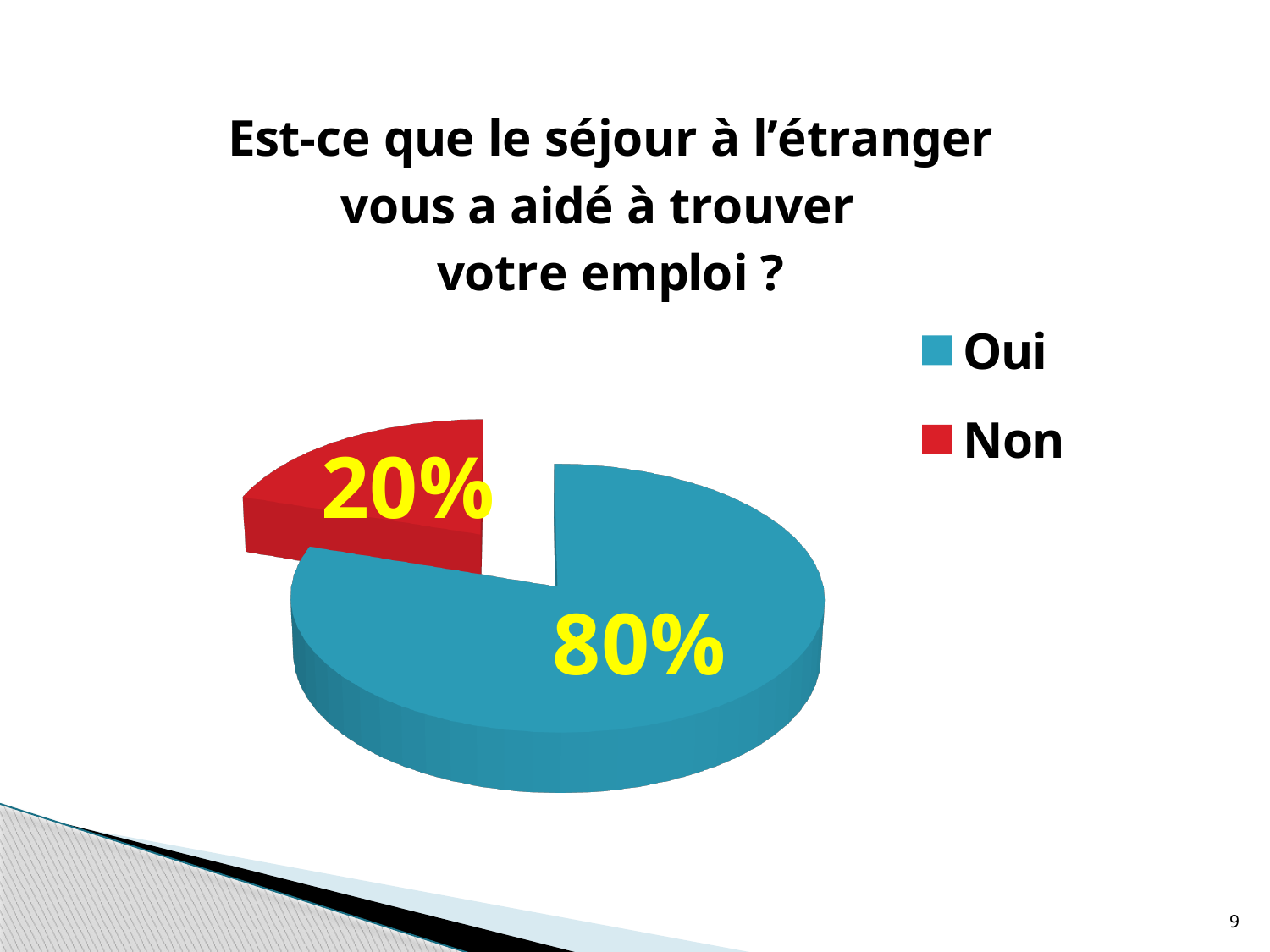
Which is larger, the share for "Oui" or the share for "Non"? Oui What percentage of respondents answered "Non"? 20% What share of the pie does the "Non" slice represent? 20% What colour is the "Non" slice? Red Which response has the smallest share of the pie? Non What is the difference in percentage points between the "Oui" and "Non" shares? 60 How many entries does the legend list? 2 Which response has the largest share of the pie? Oui What percentage of respondents answered "Oui"? 80% What colour is the "Oui" slice? Blue How many slices does the pie chart have? 2 What kind of chart is shown on the slide? Pie chart